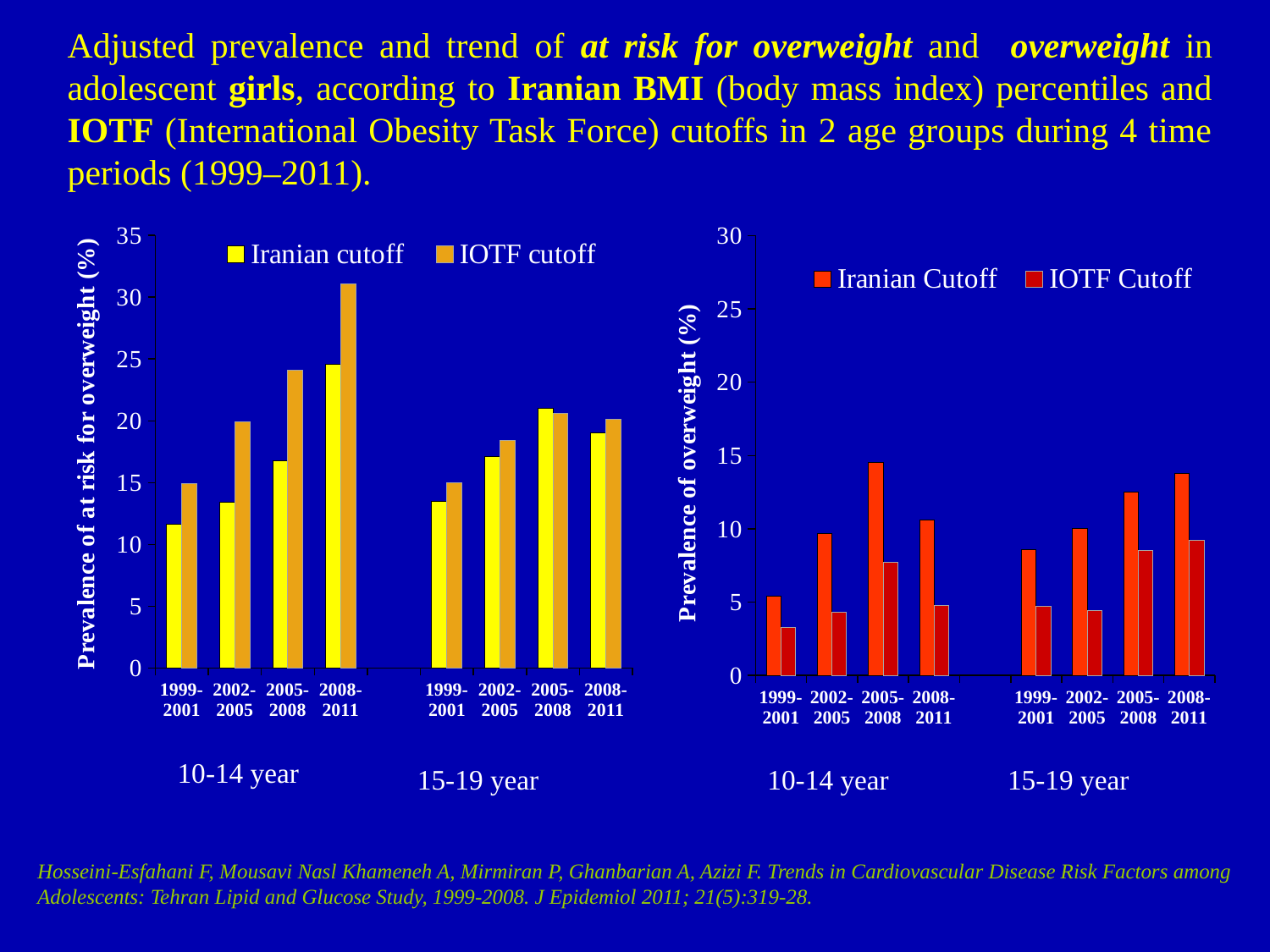
In the right chart ('Prevalence of overweight'), for 2005-2008 in the 10-14 year group, which is larger: the Iranian Cutoff or the IOTF Cutoff? Iranian Cutoff In the right chart ('Prevalence of overweight'), is the Iranian Cutoff value for 2005-2008 in the 10-14 year group greater or less than 10? greater In the right chart ('Prevalence of overweight'), which time period has the lowest IOTF Cutoff bar in the 10-14 year group? 1999-2001 In the left chart ('Prevalence of at risk for overweight'), is the Iranian cutoff value for 1999-2001 in the 10-14 year group greater or less than 15? less In the right chart ('Prevalence of overweight'), how many time periods are shown for each age group? 4 In the left chart ('Prevalence of at risk for overweight'), is the IOTF cutoff value for 2008-2011 in the 10-14 year group greater or less than 30? greater In the left chart ('Prevalence of at risk for overweight'), which time period has the highest IOTF cutoff bar in the 10-14 year group? 2008-2011 In the left chart ('Prevalence of at risk for overweight'), do the IOTF cutoff values for the 10-14 year group rise or fall across the four time periods? rise In the right chart ('Prevalence of overweight'), which time period has the highest Iranian Cutoff bar in the 15-19 year group? 2008-2011 In the right chart ('Prevalence of overweight'), what are the two legend entries? Iranian Cutoff and IOTF Cutoff In the left chart ('Prevalence of at risk for overweight'), how many series does the legend list? 2 What kind of chart is the left chart, 'Prevalence of at risk for overweight (%)'? Bar chart